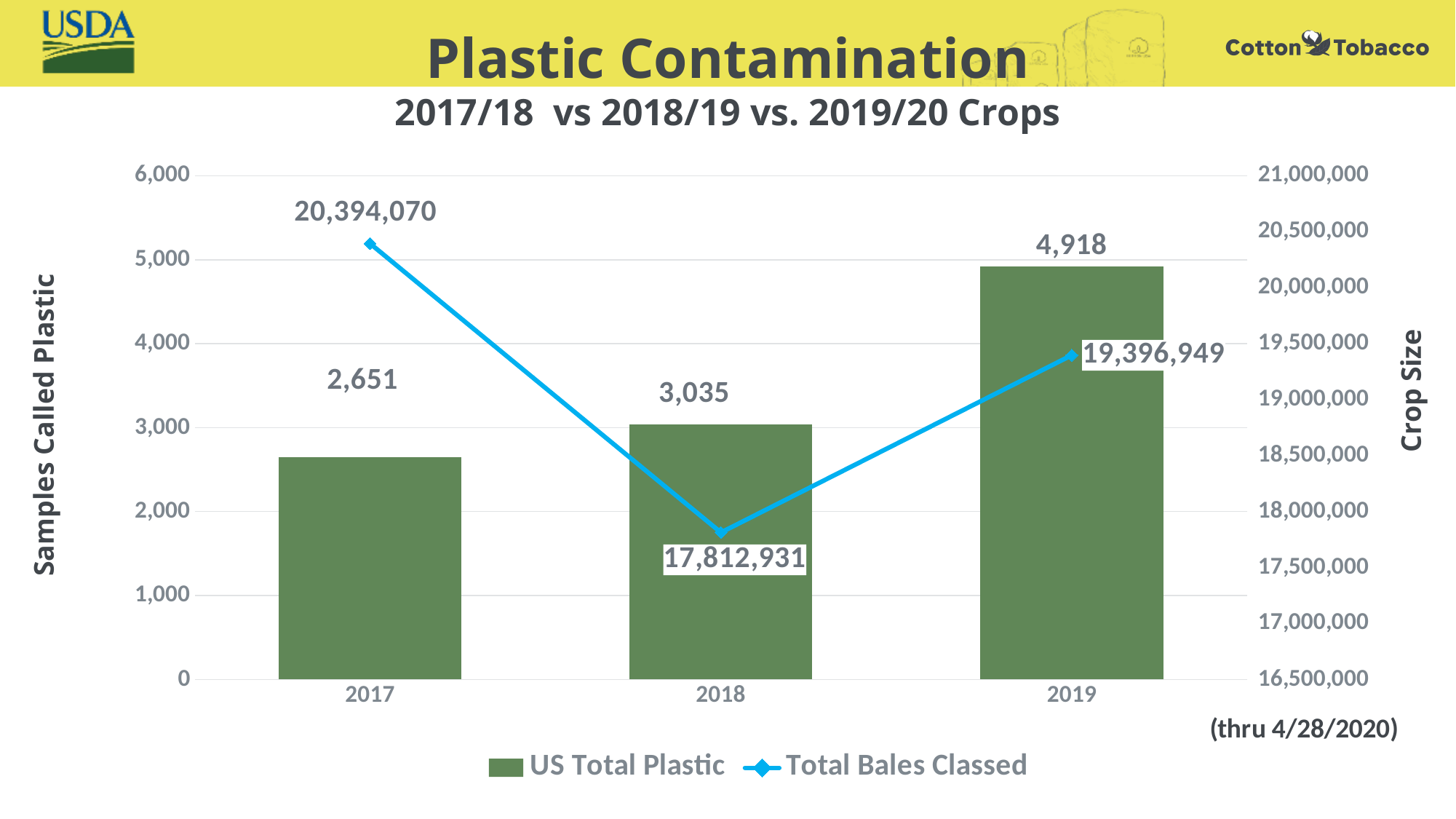
What is the US Total Plastic value for 2019? 4,918 What is the difference between the US Total Plastic values for 2019 and 2018? 1,883 Does the US Total Plastic series rise or fall from 2017 to 2019? rise What is the label of the right-hand vertical axis? Crop Size Which year has the highest US Total Plastic value? 2019 How many years are shown on the x axis? 3 How many series does the legend list? 2 Which is larger, the Total Bales Classed value for 2017 or for 2019? 2017 Which year has the lowest Total Bales Classed value? 2018 What is the Total Bales Classed value for 2017? 20,394,070 What is the Total Bales Classed value for 2018? 17,812,931 What is the US Total Plastic value for 2017? 2,651